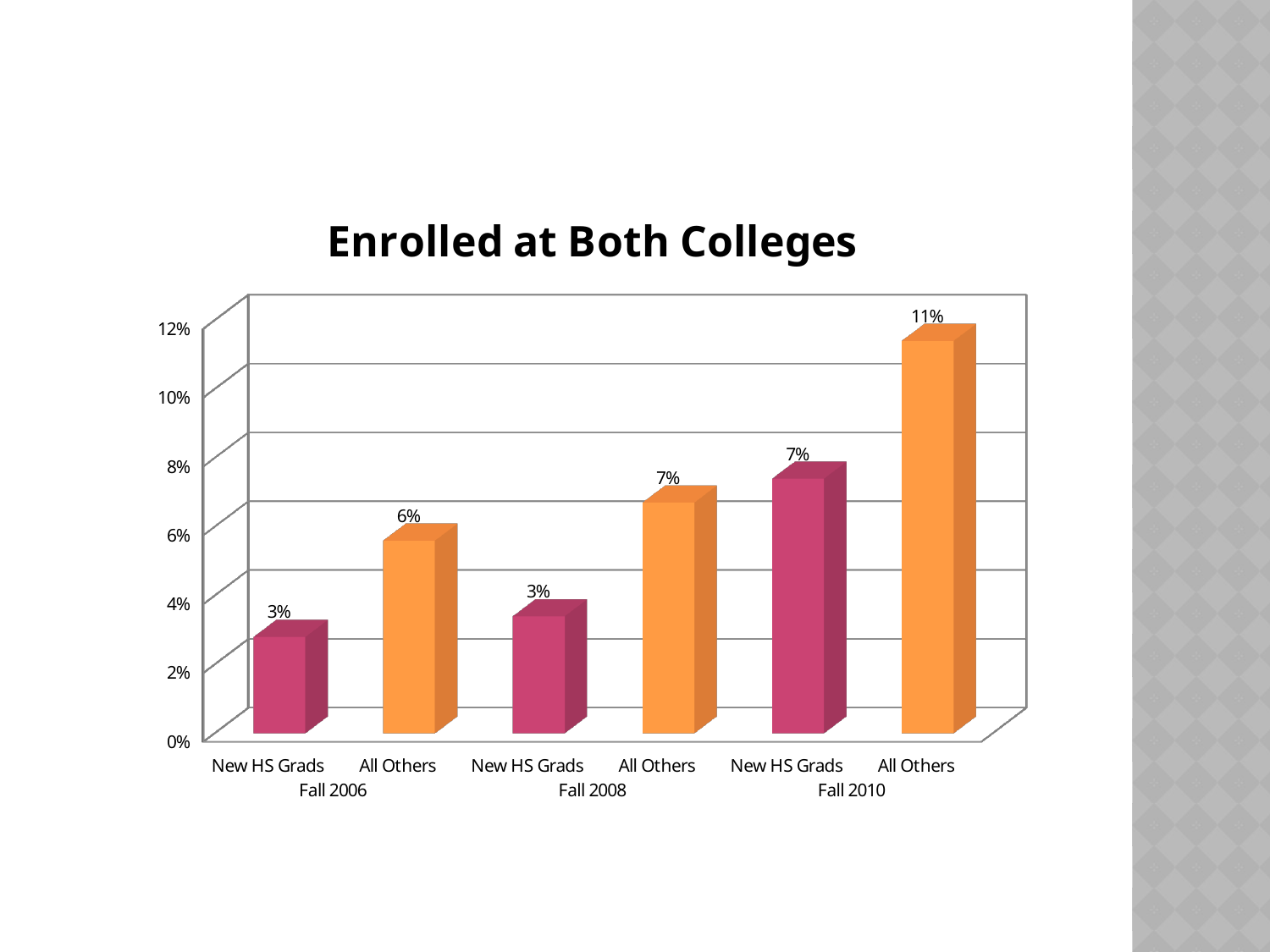
Do the All Others values rise or fall from Fall 2006 to Fall 2010? Rise What is the value for All Others in Fall 2008? 7% What is the difference between All Others in Fall 2010 and All Others in Fall 2006? 5% What is the value for New HS Grads in Fall 2010? 7% Which bar has the highest value? All Others, Fall 2010 What is the value for All Others in Fall 2010? 11% How many bars are plotted in the chart? 6 What is the value for New HS Grads in Fall 2006? 3% What is the title of the chart? Enrolled at Both Colleges Which is larger: All Others in Fall 2006 or New HS Grads in Fall 2008? All Others in Fall 2006 What is the difference between All Others and New HS Grads in Fall 2010? 4% What kind of chart is shown? Bar chart